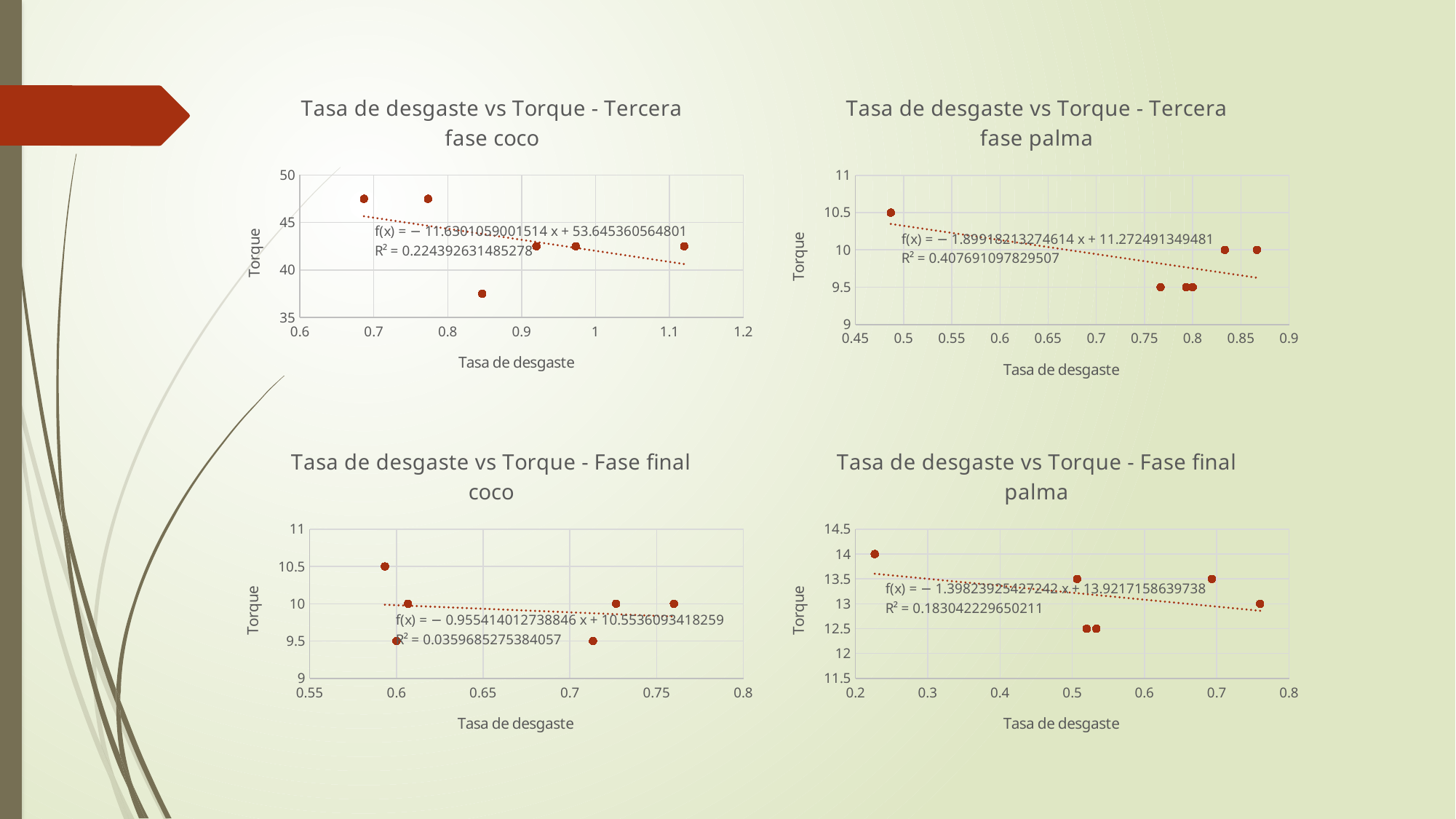
What is the label of the x axis in the "Tasa de desgaste vs Torque - Tercera fase palma" chart? Tasa de desgaste In the "Tasa de desgaste vs Torque - Tercera fase coco" chart, is the Torque of the highest points greater or less than 45? greater How many data points are plotted in the "Tasa de desgaste vs Torque - Tercera fase palma" chart? 6 In the "Tasa de desgaste vs Torque - Tercera fase palma" chart, what is the highest Torque value plotted? 10.5 In the "Tasa de desgaste vs Torque - Fase final palma" chart, does the trend line rise or fall as Tasa de desgaste increases? Falls How many data points are plotted in the "Tasa de desgaste vs Torque - Fase final palma" chart? 6 In the "Tasa de desgaste vs Torque - Tercera fase coco" chart, does the trend line rise or fall as Tasa de desgaste increases? Falls In the "Tasa de desgaste vs Torque - Fase final palma" chart, what is the lowest Torque value plotted? 12.5 What kind of chart is "Tasa de desgaste vs Torque - Tercera fase coco"? Scatter chart What is the R² value shown in the "Tasa de desgaste vs Torque - Fase final coco" chart? 0.0359685275384057 In the "Tasa de desgaste vs Torque - Fase final coco" chart, what is the highest Torque value plotted? 10.5 In the "Tasa de desgaste vs Torque - Tercera fase coco" chart, is the Torque of the lowest point greater or less than 40? less